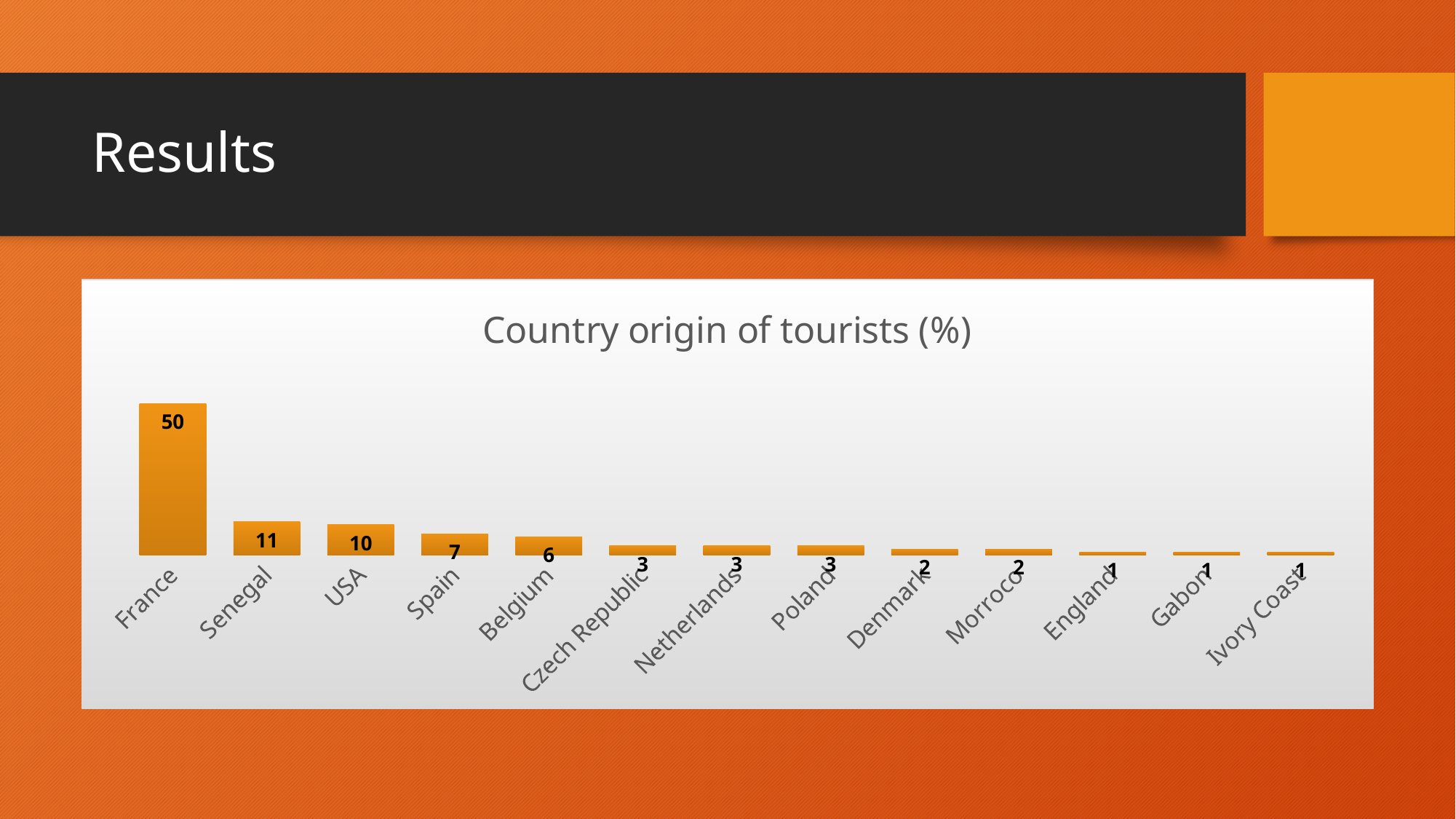
Which country has the highest value? France What is the difference between the values for France and Senegal? 39 What is the value for Senegal? 11 What is the value for France? 50 What is the value for Denmark? 2 What is the difference between the values for USA and Spain? 3 Which has a larger value, Senegal or USA? Senegal What is the title of the chart? Country origin of tourists (%) How many countries are shown in the chart? 13 Which has a larger value, Spain or Poland? Spain What kind of chart is shown on the slide? Bar chart What is the value for Belgium? 6